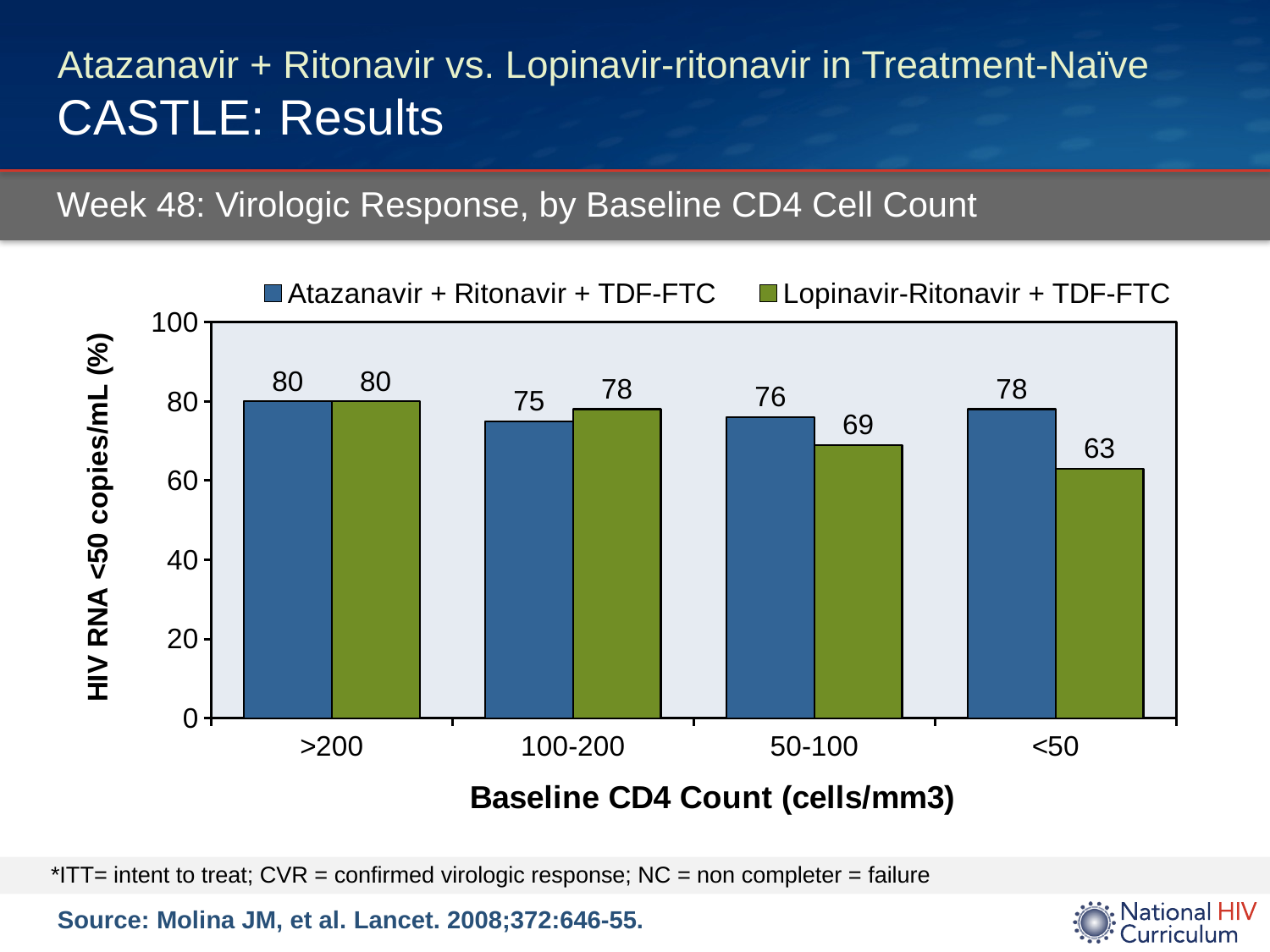
How many series does the legend list? 2 In the 100-200 group, which series has the larger value, Atazanavir + Ritonavir + TDF-FTC or Lopinavir-Ritonavir + TDF-FTC? Lopinavir-Ritonavir + TDF-FTC What is the value for Atazanavir + Ritonavir + TDF-FTC in the 100-200 baseline CD4 count group? 75 What is the value for Lopinavir-Ritonavir + TDF-FTC in the <50 baseline CD4 count group? 63 Do the values for Lopinavir-Ritonavir + TDF-FTC rise or fall from >200 to <50 along the x axis? Fall What is the value for Lopinavir-Ritonavir + TDF-FTC in the 50-100 baseline CD4 count group? 69 What kind of chart is shown on the slide? Bar chart What is the difference between the Atazanavir + Ritonavir + TDF-FTC and Lopinavir-Ritonavir + TDF-FTC values in the <50 group? 15 Is the value for Lopinavir-Ritonavir + TDF-FTC in the 50-100 group greater or less than 60? greater Which baseline CD4 count group has the lowest value for Lopinavir-Ritonavir + TDF-FTC? <50 Which baseline CD4 count group has the highest value for Atazanavir + Ritonavir + TDF-FTC? >200 How many baseline CD4 count categories are shown on the x axis? 4